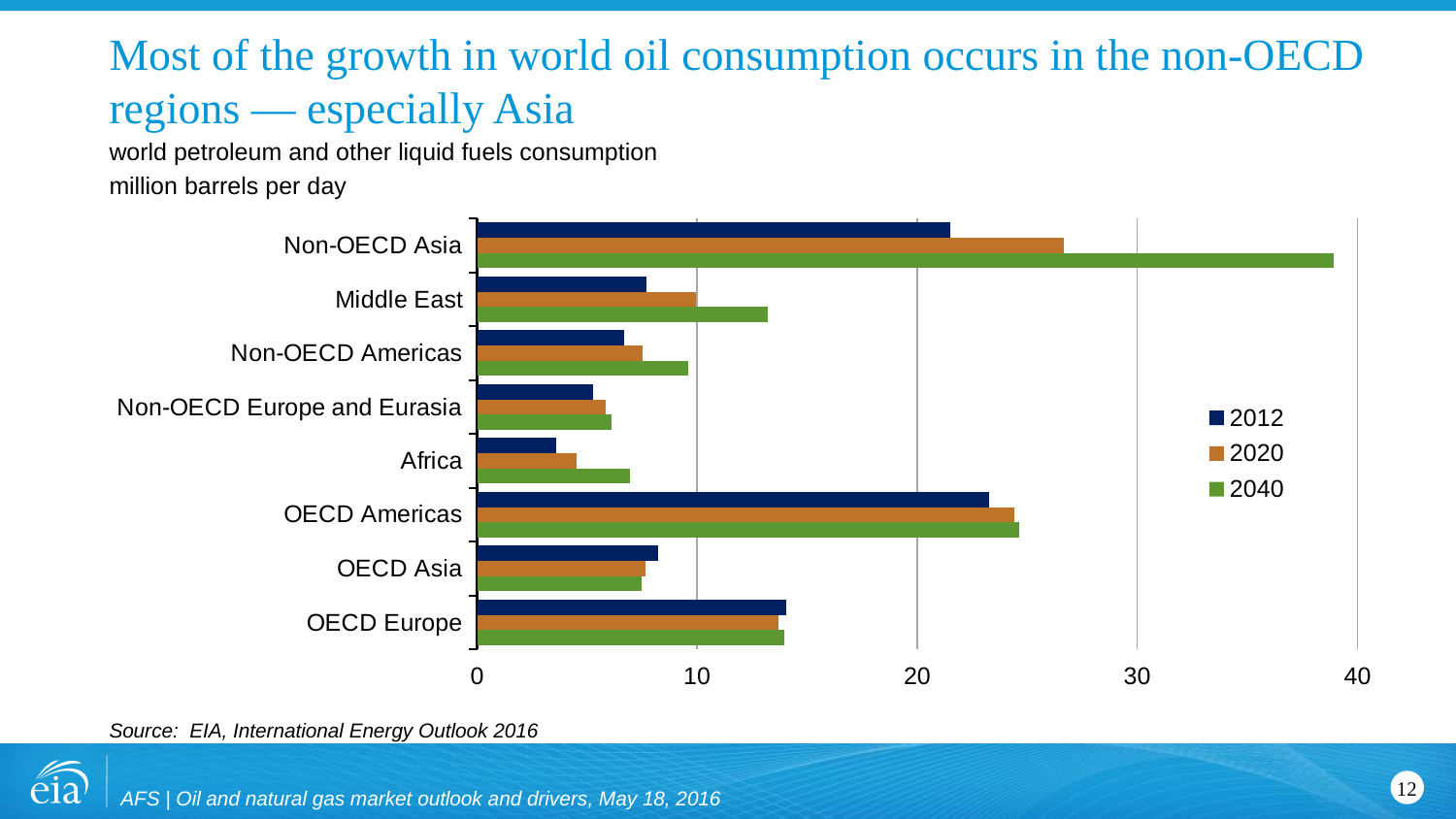
What kind of chart is shown on the slide? bar chart Which region has the lowest consumption in 2012? Africa How many series does the legend list? 3 Which region has the highest consumption in 2040? Non-OECD Asia Which years are listed in the chart legend? 2012, 2020, 2040 Which region has the highest consumption in 2012? OECD Americas Is the 2040 value for Middle East greater or less than 10? greater Which is larger in 2040: Middle East or Non-OECD Americas? Middle East How many regions are listed on the chart? 8 What unit is the chart's data measured in? million barrels per day Is the 2012 value for OECD Europe greater or less than 10? greater Is the 2040 value for Non-OECD Asia greater or less than 30? greater